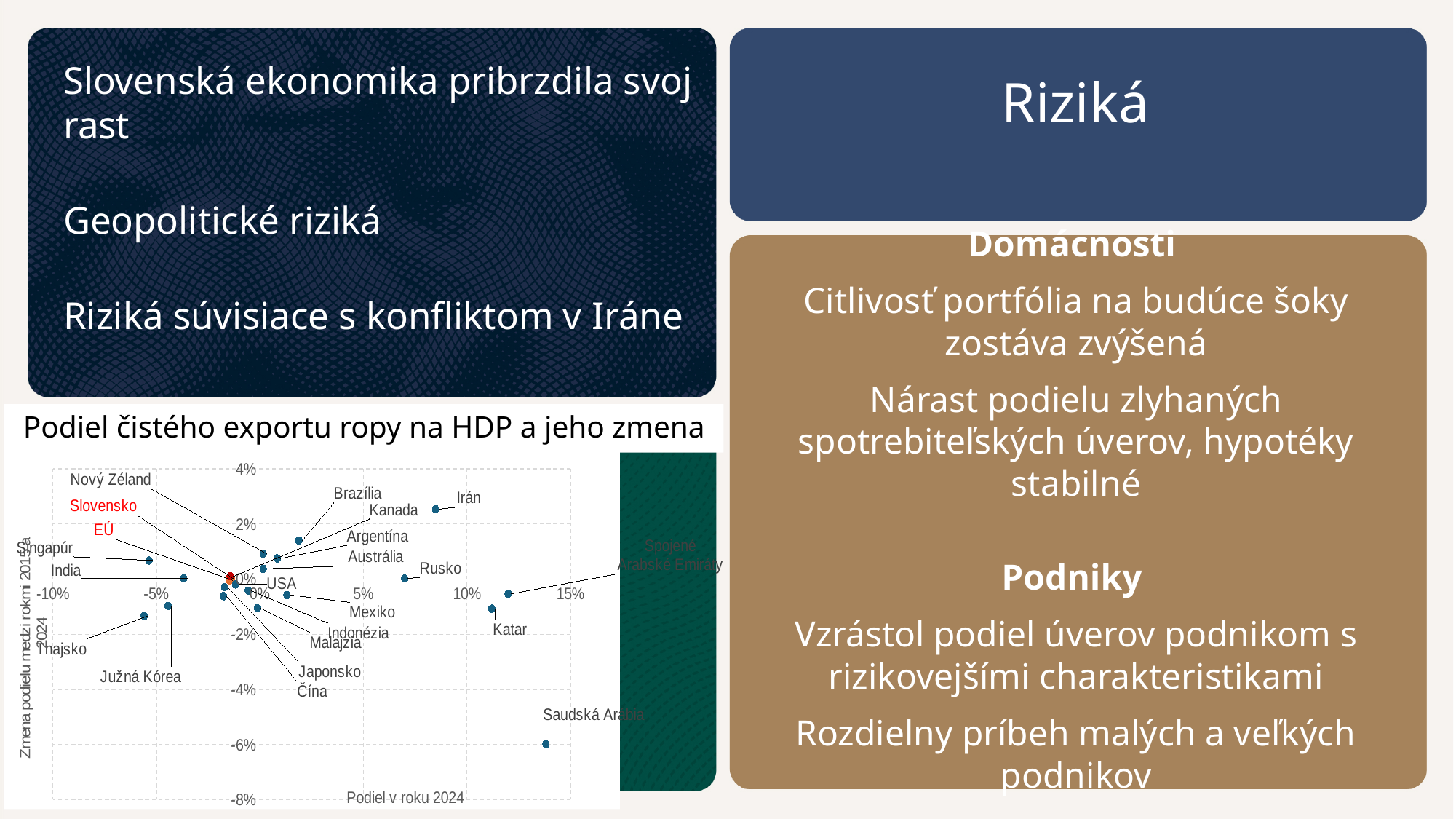
What is the title of the chart on the slide? Podiel čistého exportu ropy na HDP a jeho zmena Which country has the highest value on the vertical axis of the chart? Irán What kind of chart is shown on the slide? Scatter chart Which has the higher vertical-axis value, Katar or Saudská Arábia? Katar Which has the higher vertical-axis value, Irán or Rusko? Irán Which country has the highest value on the horizontal axis of the chart? Saudská Arábia Which country has the lowest value on the vertical axis of the chart? Saudská Arábia What is the label of the horizontal axis of the chart? Podiel v roku 2024 Is the horizontal-axis value for Katar greater or less than 10%? greater Is the vertical-axis value for Brazília greater or less than 0%? greater Is the vertical-axis value for Saudská Arábia greater or less than -4%? less